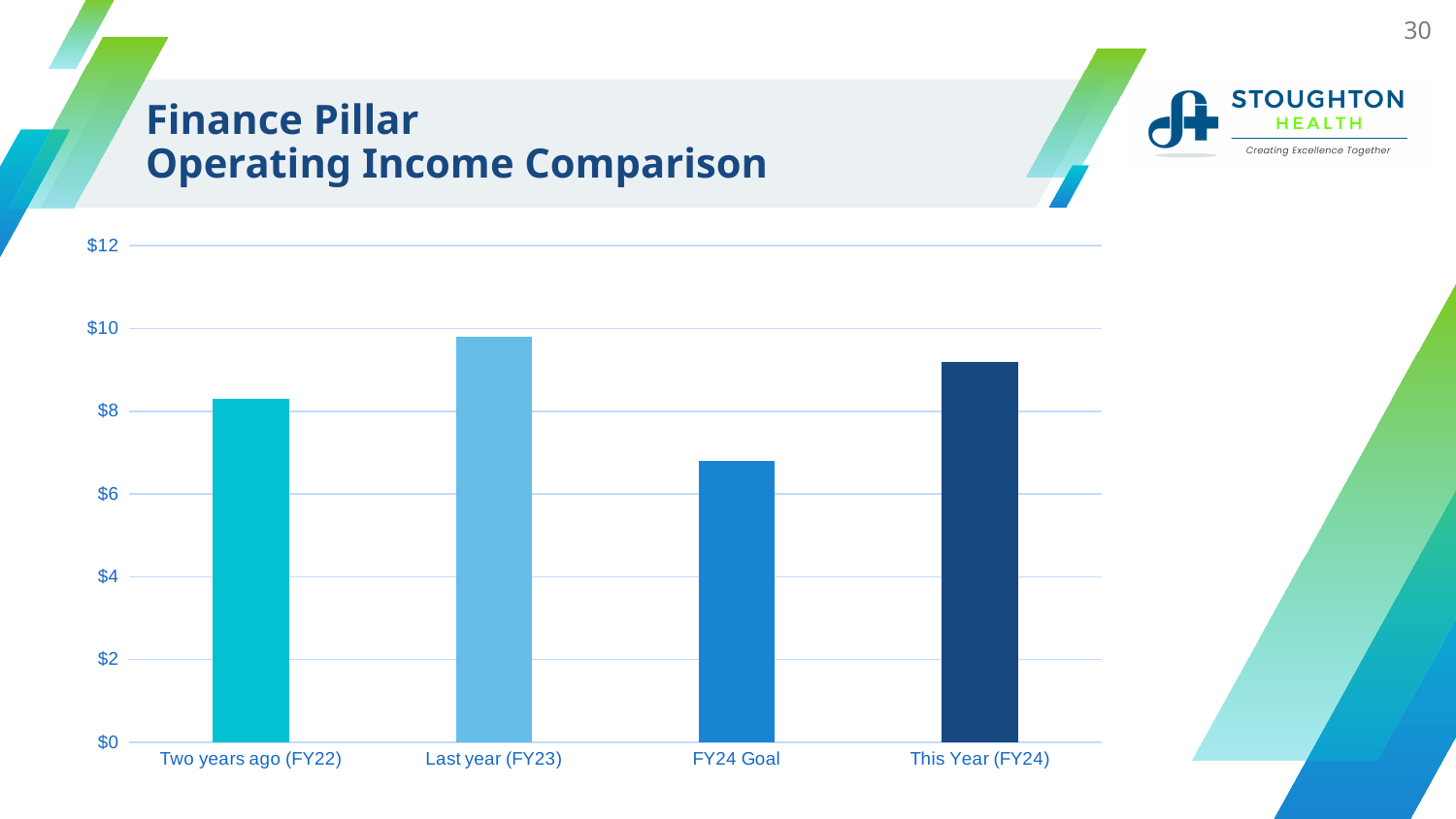
Which category has the highest bar in the chart? Last year (FY23) Which is larger, the value for Two years ago (FY22) or the value for Last year (FY23)? Last year (FY23) How many categories are shown on the x axis of the chart? 4 What is the title of the chart on the slide? Finance Pillar Operating Income Comparison Is the value for Two years ago (FY22) greater or less than $8? greater Is the value for FY24 Goal greater or less than $6? greater What kind of chart is shown on the slide? bar chart Which category has the lowest bar in the chart? FY24 Goal Which is larger, the value for This Year (FY24) or the value for FY24 Goal? This Year (FY24) Is the value for Last year (FY23) greater or less than $10? less